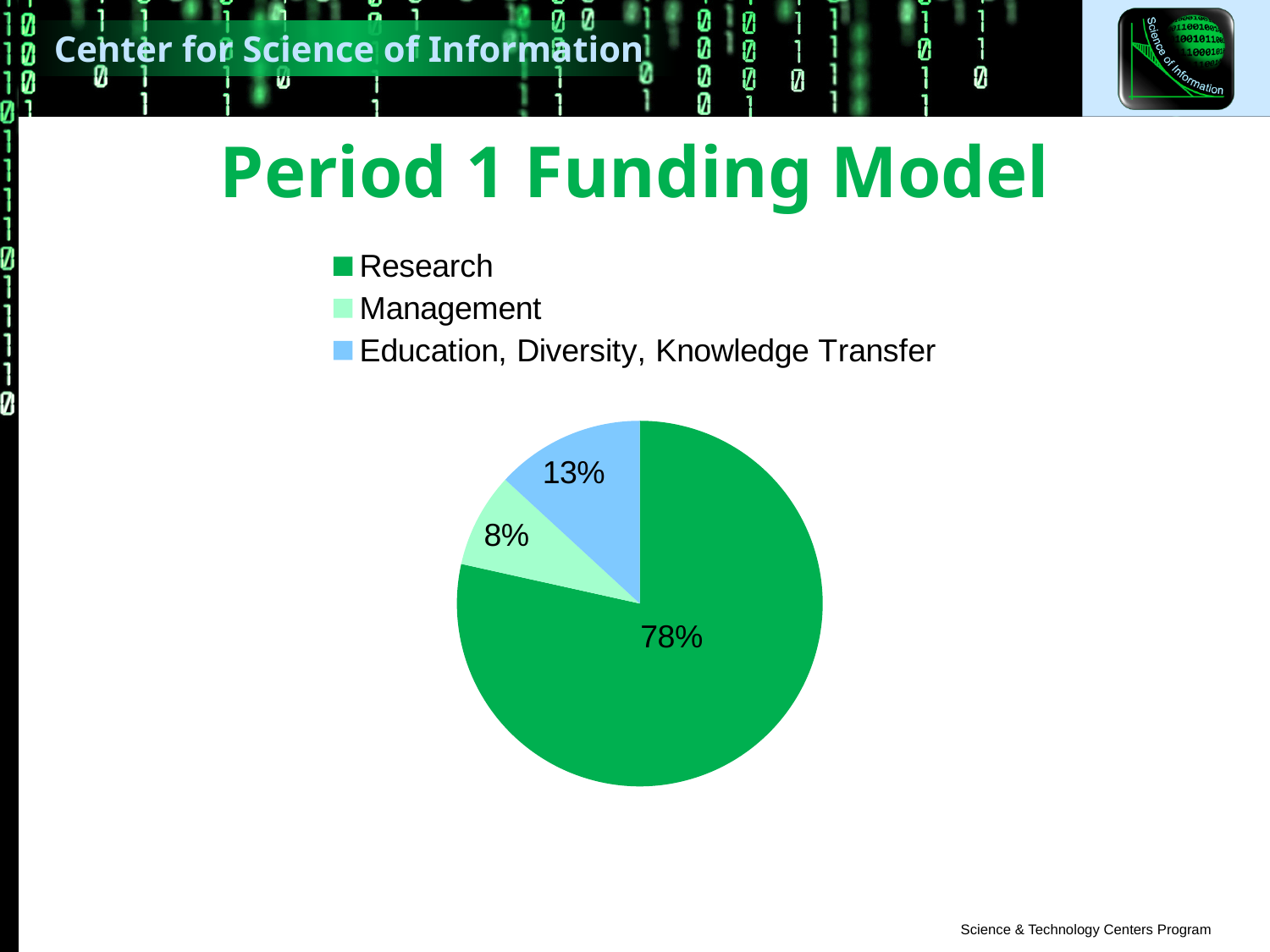
What share of the pie does Research account for? 78% How many categories does the pie chart show? 3 What share of the pie does Management account for? 8% How many entries does the legend list? 3 What kind of chart is shown on the slide? pie chart What is the title of the chart on the slide? Period 1 Funding Model What is the difference in percentage points between the Research slice and the Education, Diversity, Knowledge Transfer slice? 65 What share of the pie does Education, Diversity, Knowledge Transfer account for? 13% What colour is the Research slice of the pie? green Which category has the largest slice of the pie? Research Which category has the smallest slice of the pie? Management Which is larger, the Management slice or the Education, Diversity, Knowledge Transfer slice? Education, Diversity, Knowledge Transfer